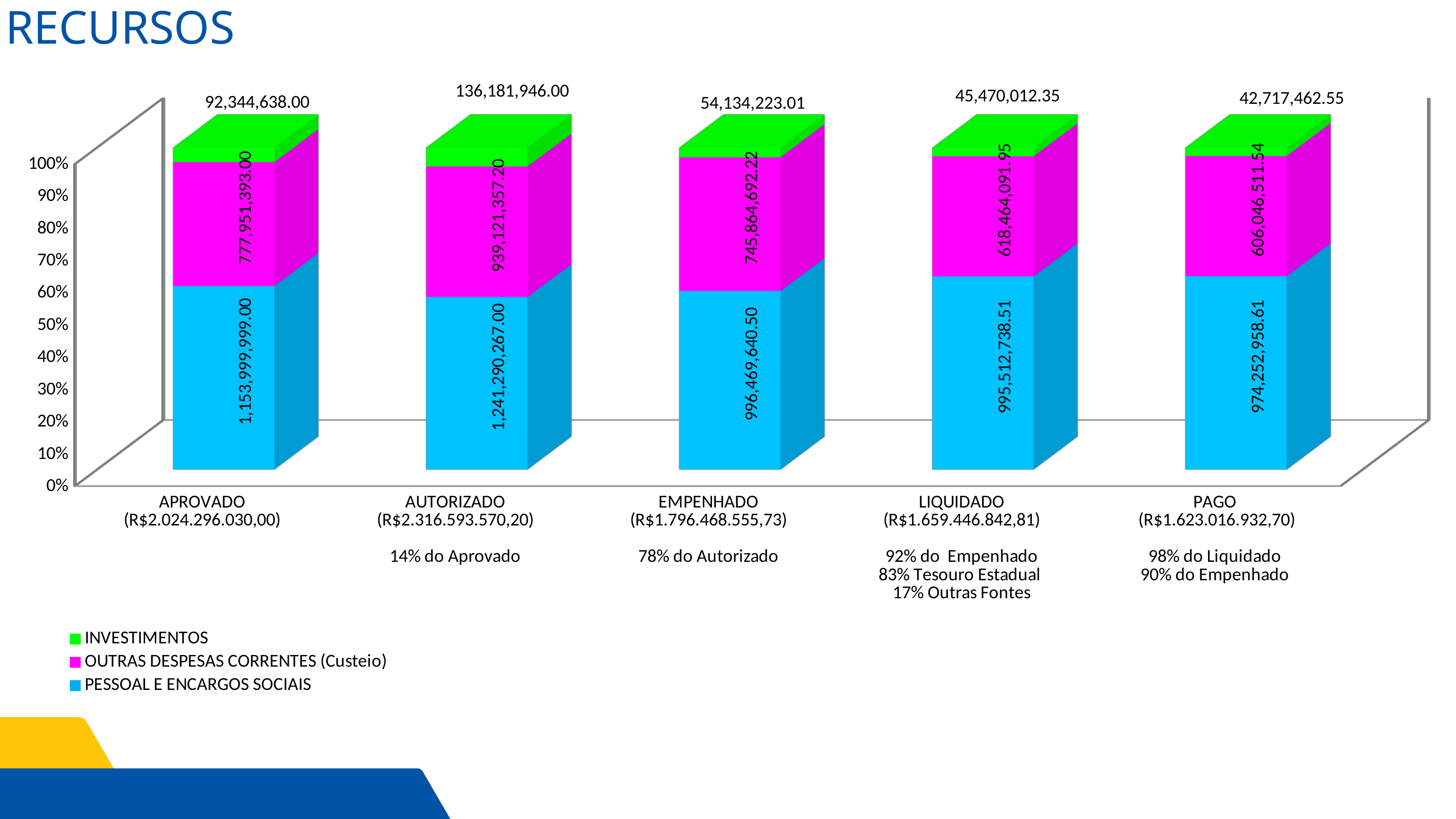
Which category has the highest INVESTIMENTOS value? AUTORIZADO What is the value of PESSOAL E ENCARGOS SOCIAIS for EMPENHADO? 996,469,640.50 What is the difference between the OUTRAS DESPESAS CORRENTES (Custeio) values for EMPENHADO and LIQUIDADO? 127,400,600.27 How many series does the legend list? 3 What is the difference between the PESSOAL E ENCARGOS SOCIAIS values for AUTORIZADO and APROVADO? 87,290,268.00 How many categories are shown on the x axis? 5 Is the PESSOAL E ENCARGOS SOCIAIS share of the APROVADO bar greater or less than 50%? greater What kind of chart is shown on the slide? Stacked bar chart Which category has the lowest INVESTIMENTOS value? PAGO Which is larger, the INVESTIMENTOS value for LIQUIDADO or for PAGO? LIQUIDADO What is the value of OUTRAS DESPESAS CORRENTES (Custeio) for PAGO? 606,046,511.54 What is the value of INVESTIMENTOS for AUTORIZADO? 136,181,946.00